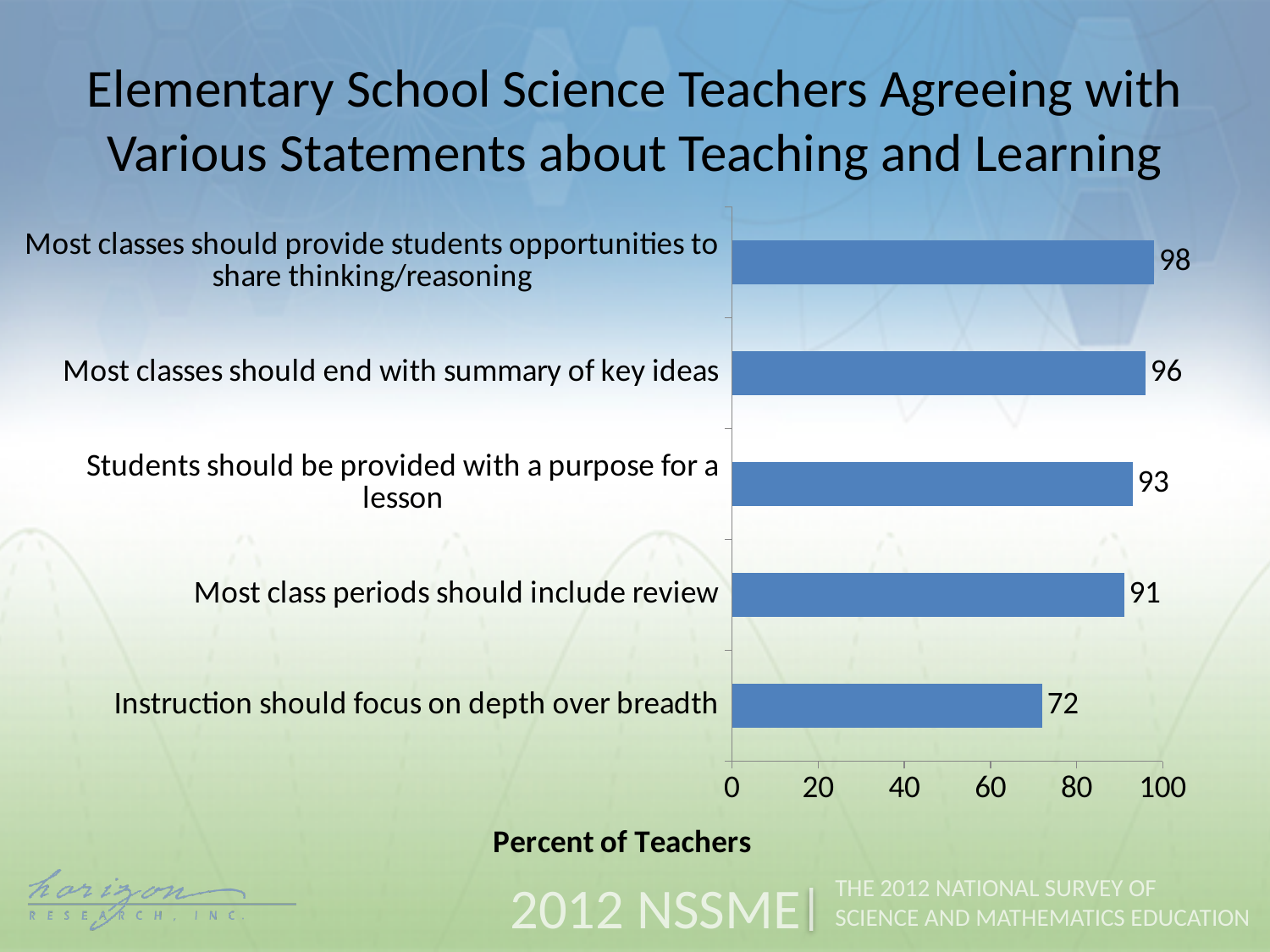
What kind of chart is shown on the slide? Bar chart What percent of teachers agree that most class periods should include review? 91 Which statement has the lowest percent of teachers agreeing? Instruction should focus on depth over breadth What percent of teachers agree that students should be provided with a purpose for a lesson? 93 How many statements are shown in the chart? 5 What is the label of the horizontal axis? Percent of Teachers What percent of teachers agree that most classes should provide students opportunities to share thinking/reasoning? 98 What percent of teachers agree that instruction should focus on depth over breadth? 72 Is the value for 'Instruction should focus on depth over breadth' greater or less than 80? less Which has a higher percent of teachers agreeing: 'Most classes should end with summary of key ideas' or 'Most class periods should include review'? Most classes should end with summary of key ideas Which statement has the highest percent of teachers agreeing? Most classes should provide students opportunities to share thinking/reasoning What is the difference in percent of teachers between 'Most classes should end with summary of key ideas' and 'Instruction should focus on depth over breadth'? 24